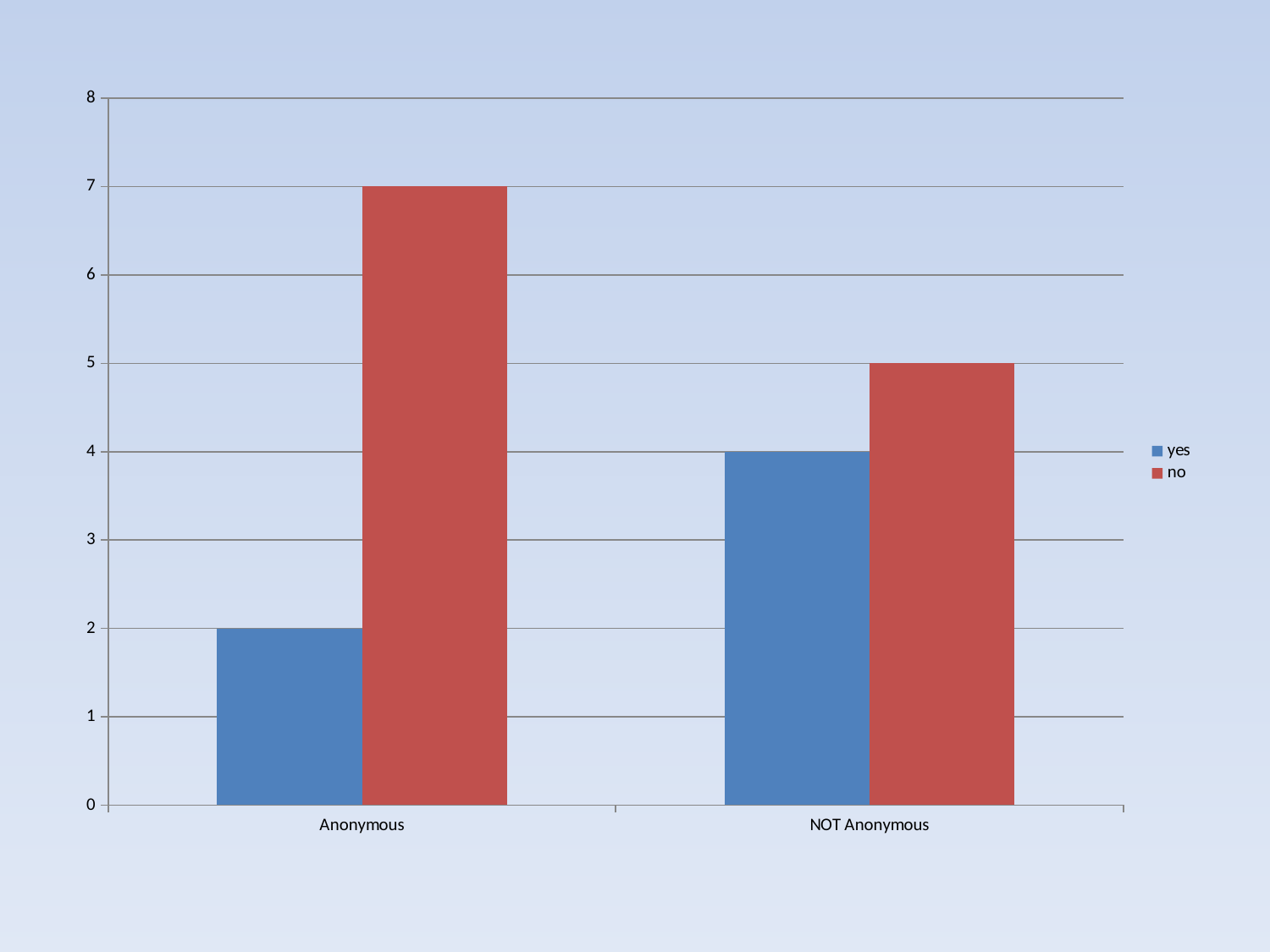
How many series does the legend list? 2 Which colour represents the "no" series in the legend? red Which category has the highest "no" value? Anonymous What is the value of the "yes" bar for Anonymous? 2 Which is larger for NOT Anonymous, the "yes" value or the "no" value? no What is the difference between the "no" and "yes" values for Anonymous? 5 How many categories are shown on the x axis? 2 What is the value of the "yes" bar for NOT Anonymous? 4 What is the value of the "no" bar for Anonymous? 7 Which category has the lowest "yes" value? Anonymous What is the value of the "no" bar for NOT Anonymous? 5 What kind of chart is shown on the slide? bar chart